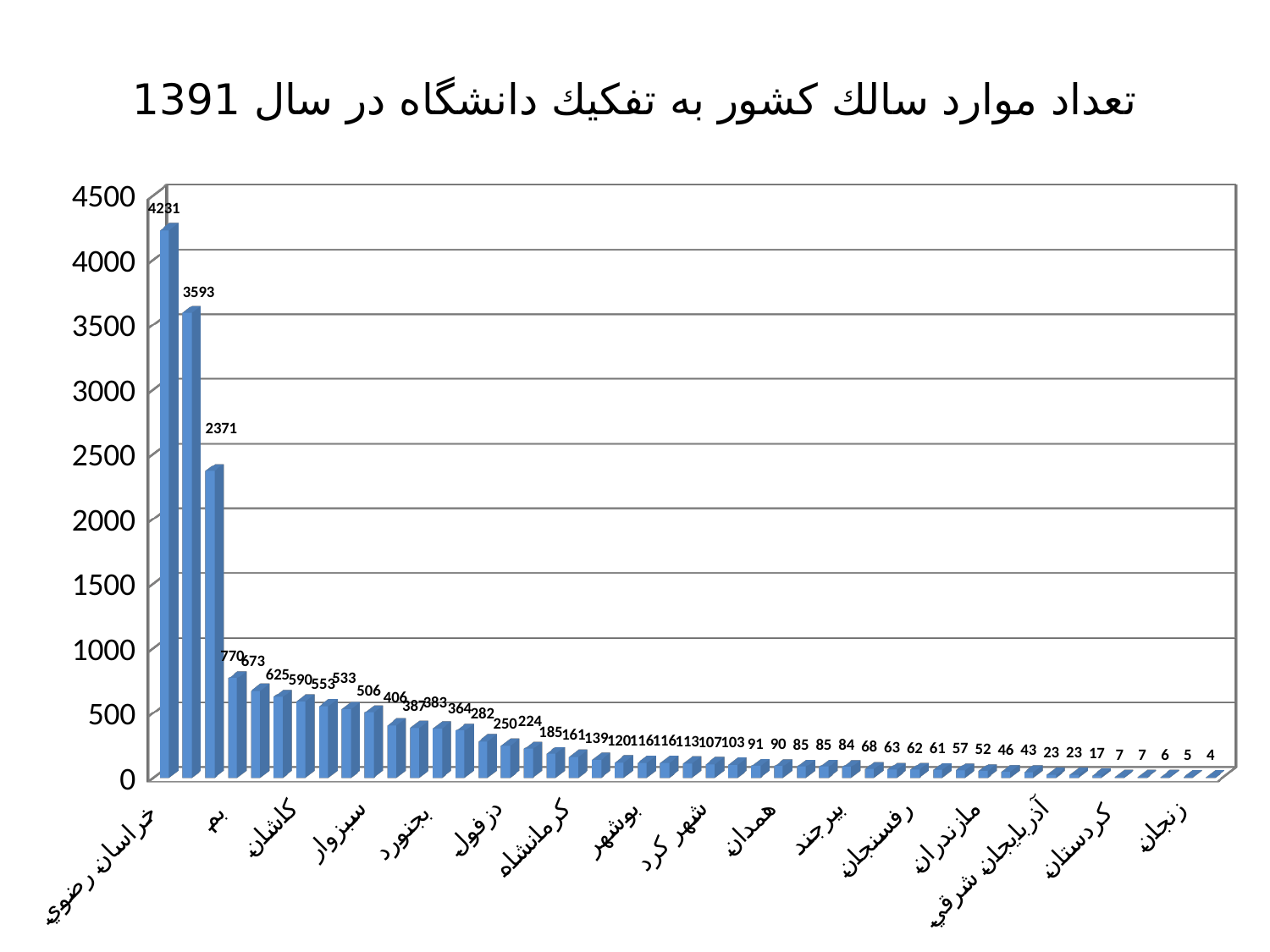
Do the values generally rise or fall from left to right along the x axis? fall What is the value of the smallest bar in the chart? 4 What is the difference between the second-highest value (3593) and the third-highest value (2371)? 1222 What is the title of the chart? تعداد موارد سالك كشور به تفكيك دانشگاه در سال 1391 What is the value for خراسان رضوي? 4231 Which category has the highest value in the chart? خراسان رضوي What is the value of the tallest bar in the chart? 4231 What kind of chart is shown on the slide? bar chart Is the value for خراسان رضوي greater or less than 4000? greater Is the third bar from the left greater or less than 2500? less What is the difference between the two highest values in the chart (4231 and 3593)? 638 What is the highest value shown on the vertical axis? 4500